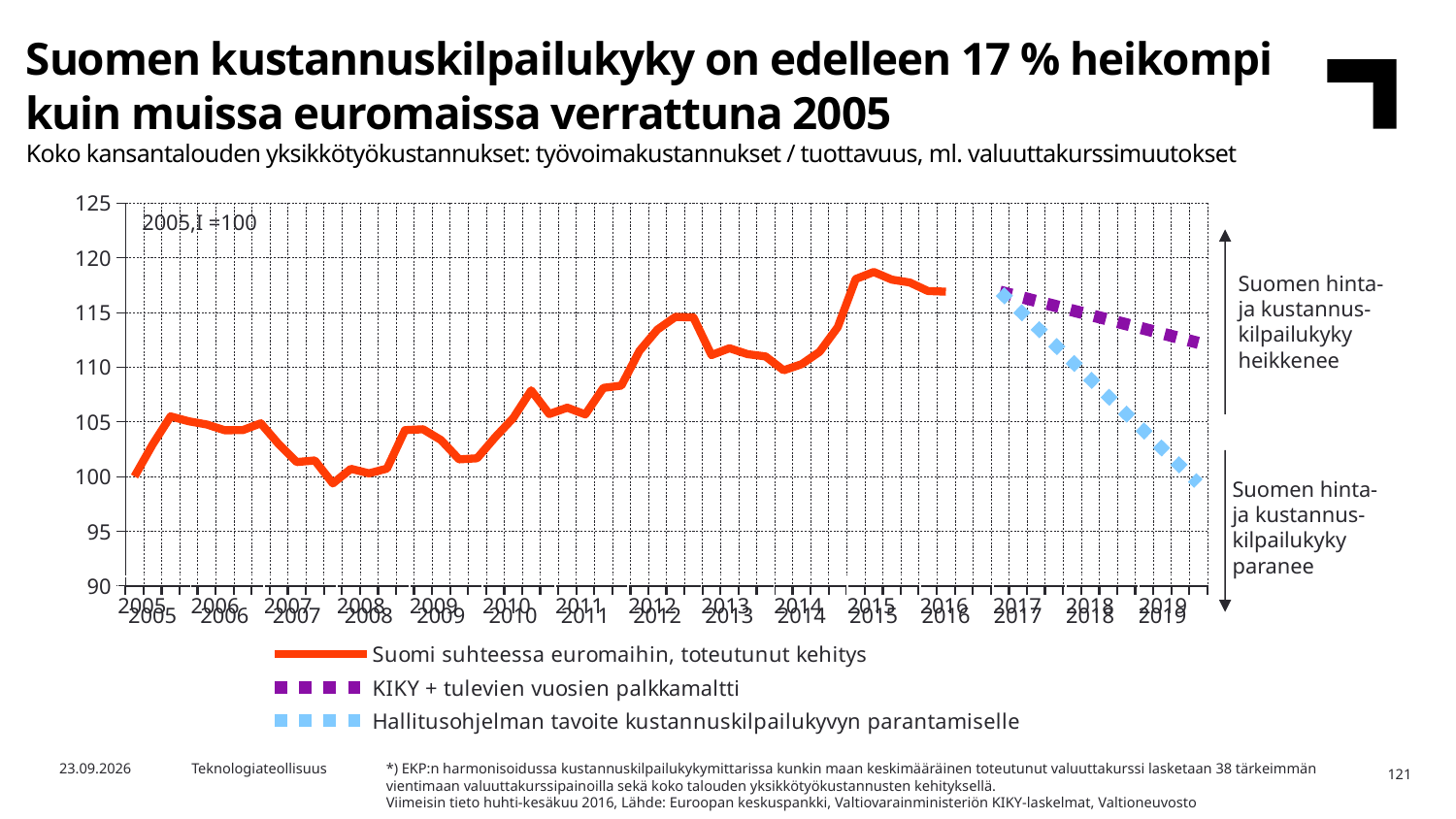
Which is larger for the red line 'Suomi suhteessa euromaihin, toteutunut kehitys': the value in 2010 or the value in 2015? 2015 Is the end value of the light blue dashed series 'Hallitusohjelman tavoite kustannuskilpailukyvyn parantamiselle' in 2019 greater or less than 105? less In which year does the red line 'Suomi suhteessa euromaihin, toteutunut kehitys' reach its highest value? 2015 Which legend entry is drawn as a solid red line? Suomi suhteessa euromaihin, toteutunut kehitys Is the end value of the purple dashed series 'KIKY + tulevien vuosien palkkamaltti' in 2019 greater or less than 110? greater Is the value of the red line 'Suomi suhteessa euromaihin, toteutunut kehitys' in 2009 greater or less than 105? less Does the light blue dashed series 'Hallitusohjelman tavoite kustannuskilpailukyvyn parantamiselle' rise or fall from 2017 to 2019? fall How many series does the legend list? 3 What is the index value of the series 'Suomi suhteessa euromaihin, toteutunut kehitys' at the start of 2005? 100 What kind of chart is shown on the slide? line chart How many years are labelled on the x axis? 15